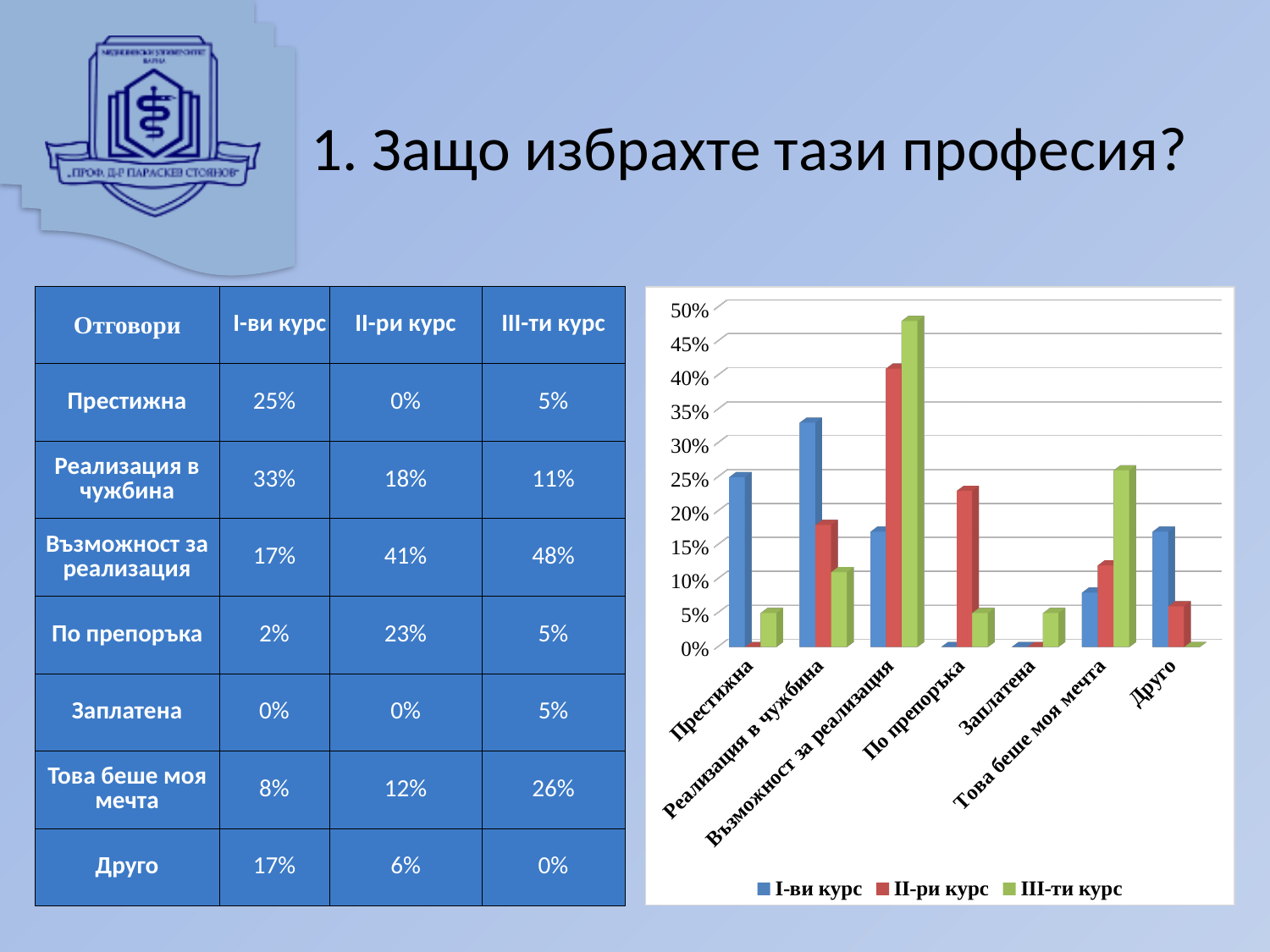
What kind of chart is shown on the slide? bar chart What is the value for II-ри курс in the category По препоръка? 23% How many series does the chart legend list? 3 How many categories are shown on the x axis of the chart? 7 Is the value for III-ти курс in the category Това беше моя мечта greater or less than 20%? greater In the category Престижна, which is larger: I-ви курс or III-ти курс? I-ви курс What are the three entries in the chart legend? I-ви курс, II-ри курс, III-ти курс What is the difference between III-ти курс and II-ри курс in the category Възможност за реализация? 7% Which category has the highest value for I-ви курс? Реализация в чужбина Which category has the tallest bar in the chart? Възможност за реализация What is the value for I-ви курс in the category Реализация в чужбина? 33% Is the value for I-ви курс in the category Друго greater or less than 20%? less